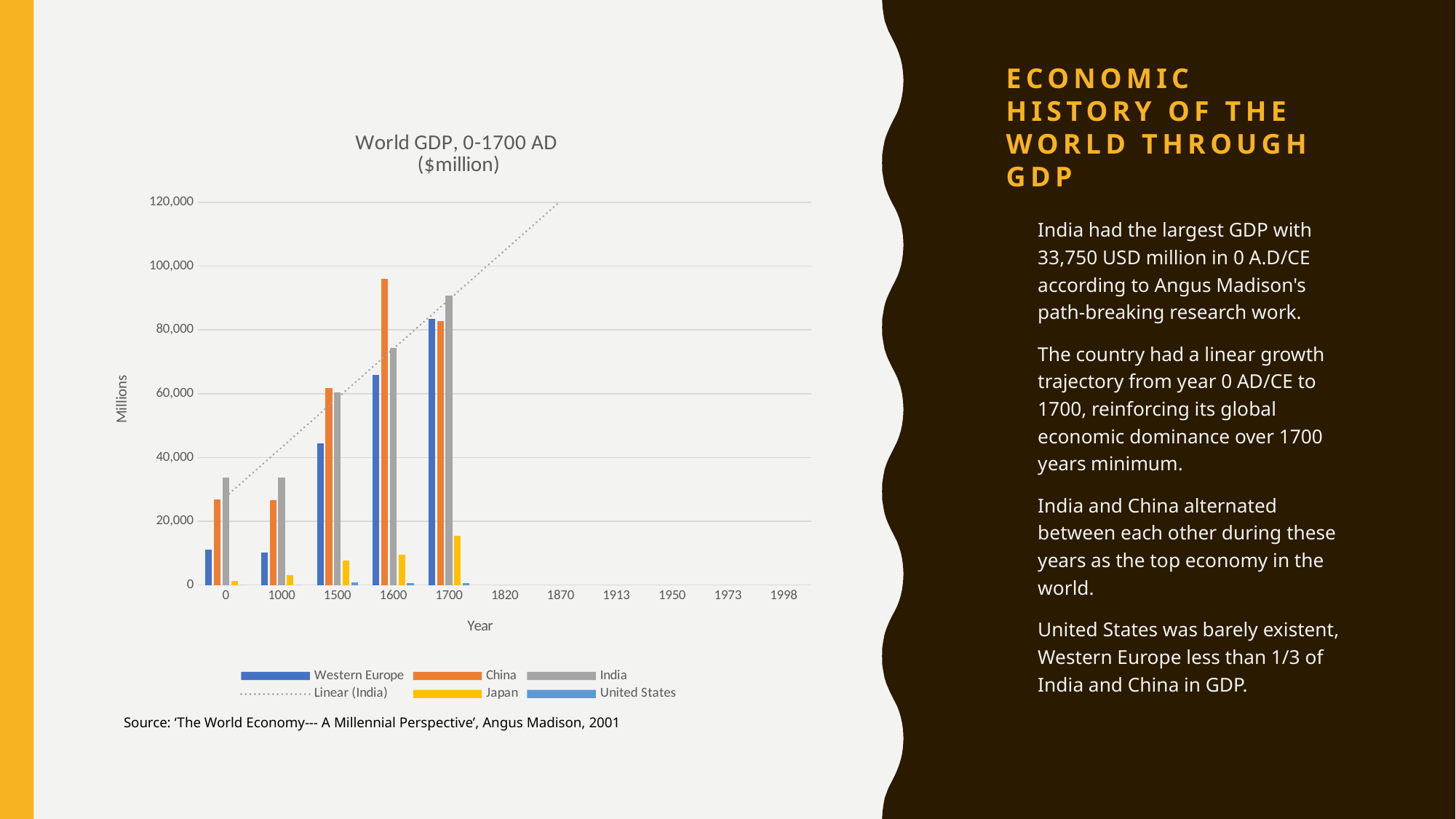
How many entries does the chart legend list? 6 How many year categories are shown on the x axis of the chart? 11 What kind of chart is shown on the slide? bar chart What is the title of the chart? World GDP, 0-1700 AD ($million) Is the value for China in 1600 greater or less than 80,000? greater Which series has the shortest bar in the year 1700? United States Does the Western Europe series rise or fall from year 0 to year 1700? rise In the year 0, which is larger, the bar for India or the bar for China? India Which series has the tallest bar in the year 1600? China Is the value for Western Europe in 0 greater or less than 20,000? less In the year 1700, which is larger, the bar for India or the bar for China? India Is the value for Japan in 1700 greater or less than 20,000? less